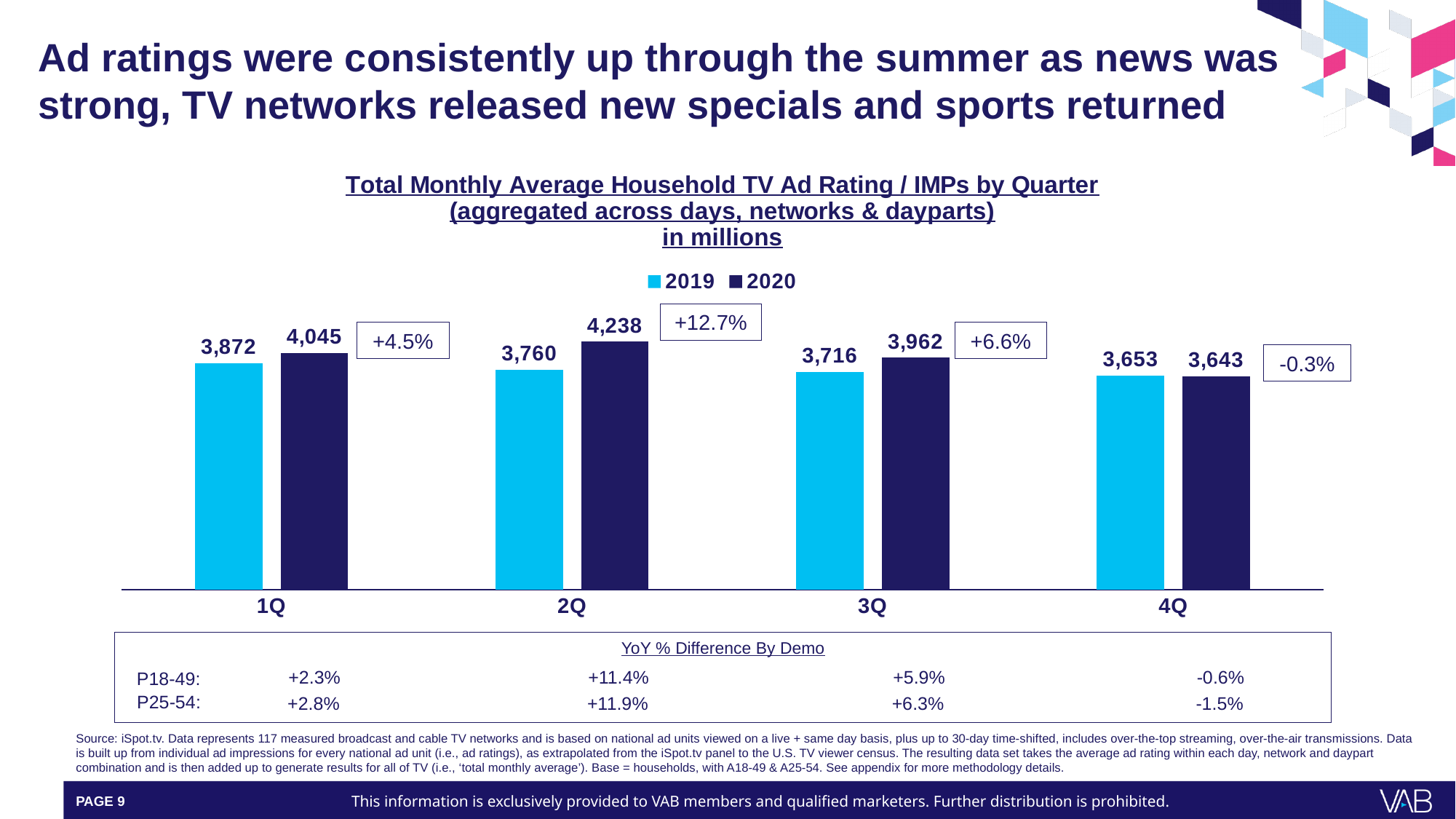
Do the 2019 values rise or fall from 1Q to 4Q? Fall Which quarter has the lowest 2019 value? 4Q What is the 2020 value for 1Q? 4,045 What is the 2020 value for 2Q? 4,238 What kind of chart is shown on the slide? Bar chart What is the difference between the 2020 and 2019 values for 3Q? 246 How many quarters are shown on the x axis? 4 What is the 2019 value for 4Q? 3,653 Which is larger for 4Q, the 2019 value or the 2020 value? 2019 What year-over-year percentage change is shown for 2Q? +12.7% How many series does the legend list? 2 Which quarter has the highest 2020 value? 2Q